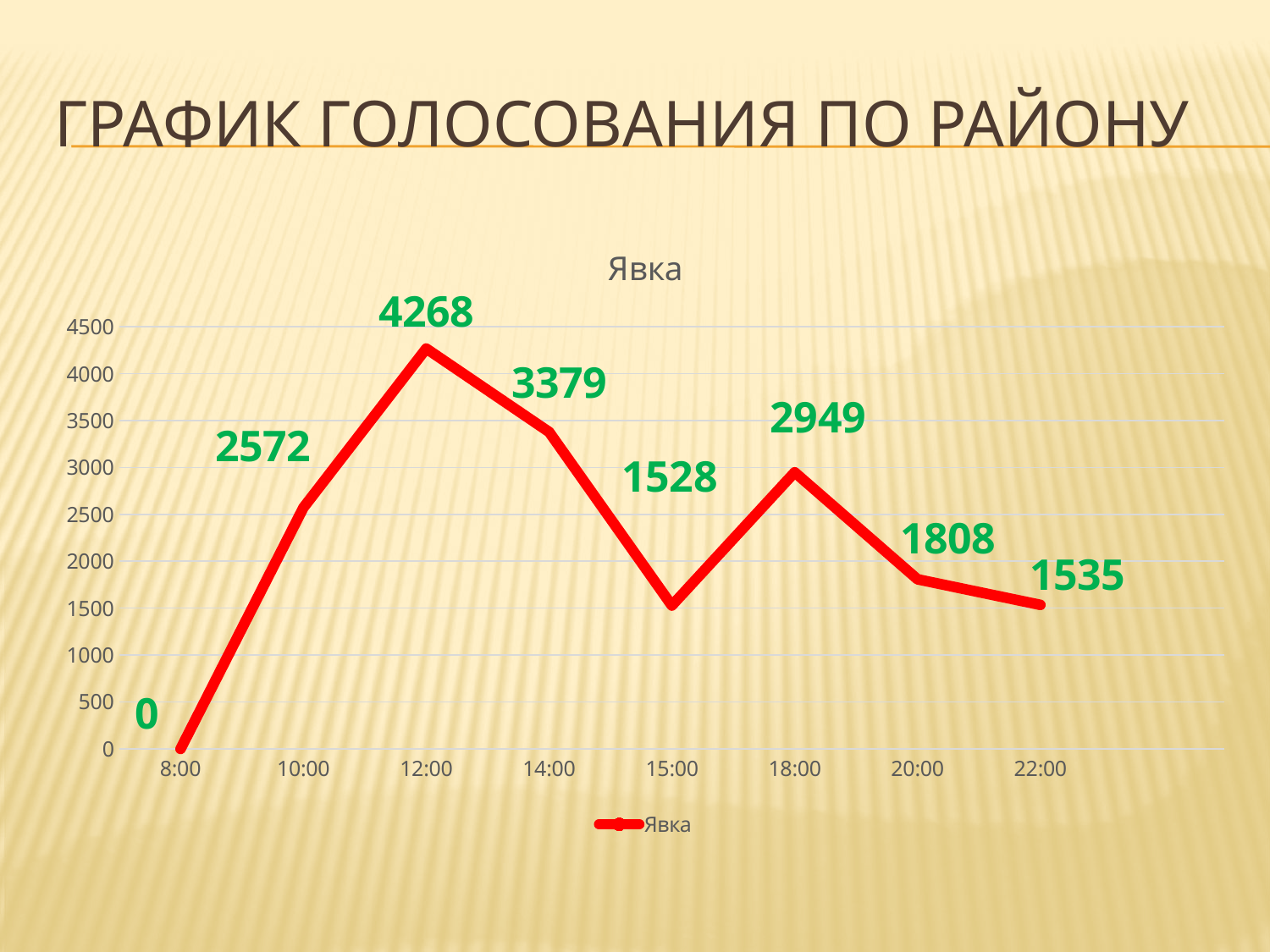
What kind of chart is shown? line chart At which time is the value lowest? 8:00 Is the value for 20:00 greater or less than 2000? less What is the title of the chart? Явка What is the value for 12:00? 4268 How many series does the legend list? 1 Which is larger, the value at 10:00 or the value at 18:00? 18:00 At which time is the value highest? 12:00 What is the difference between the values at 12:00 and 14:00? 889 What is the value for 15:00? 1528 What is the value for 22:00? 1535 How many time points are plotted on the chart? 8